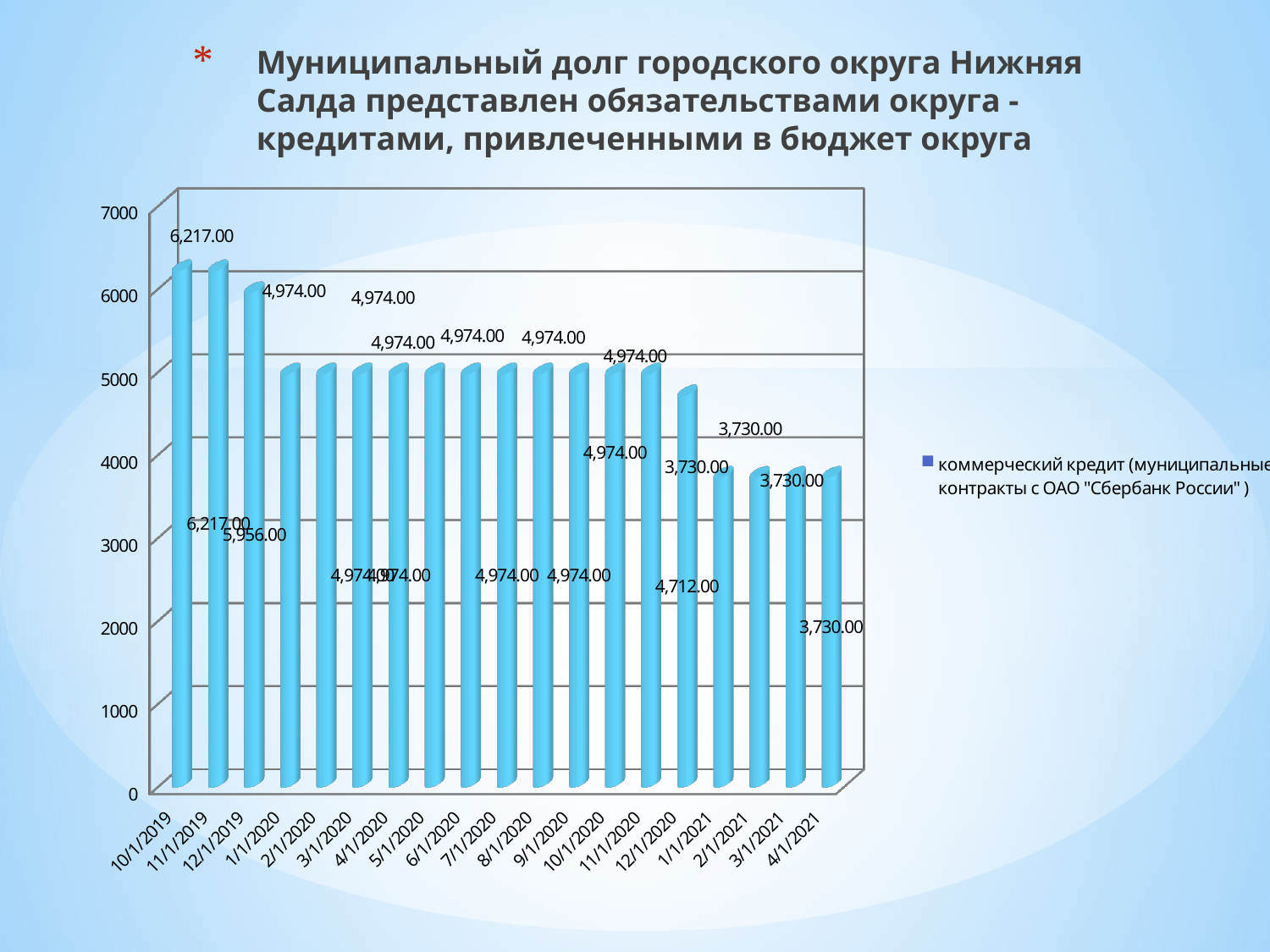
How many dates (bars) are plotted along the x axis? 19 Do the values generally rise or fall from 10/1/2019 to 4/1/2021? fall What is the value for 10/1/2019? 6,217.00 How many series does the legend list? 1 What is the difference between the value for 10/1/2019 and the value for 4/1/2021? 2,487.00 What is the lowest value shown in the chart? 3,730.00 What kind of chart is shown on the slide? bar chart What is the highest value shown in the chart? 6,217.00 What is the value for 12/1/2019? 5,956.00 What is the value for 4/1/2021? 3,730.00 What is the value for 12/1/2020? 4,712.00 Which is larger, the value for 12/1/2019 or the value for 12/1/2020? 12/1/2019